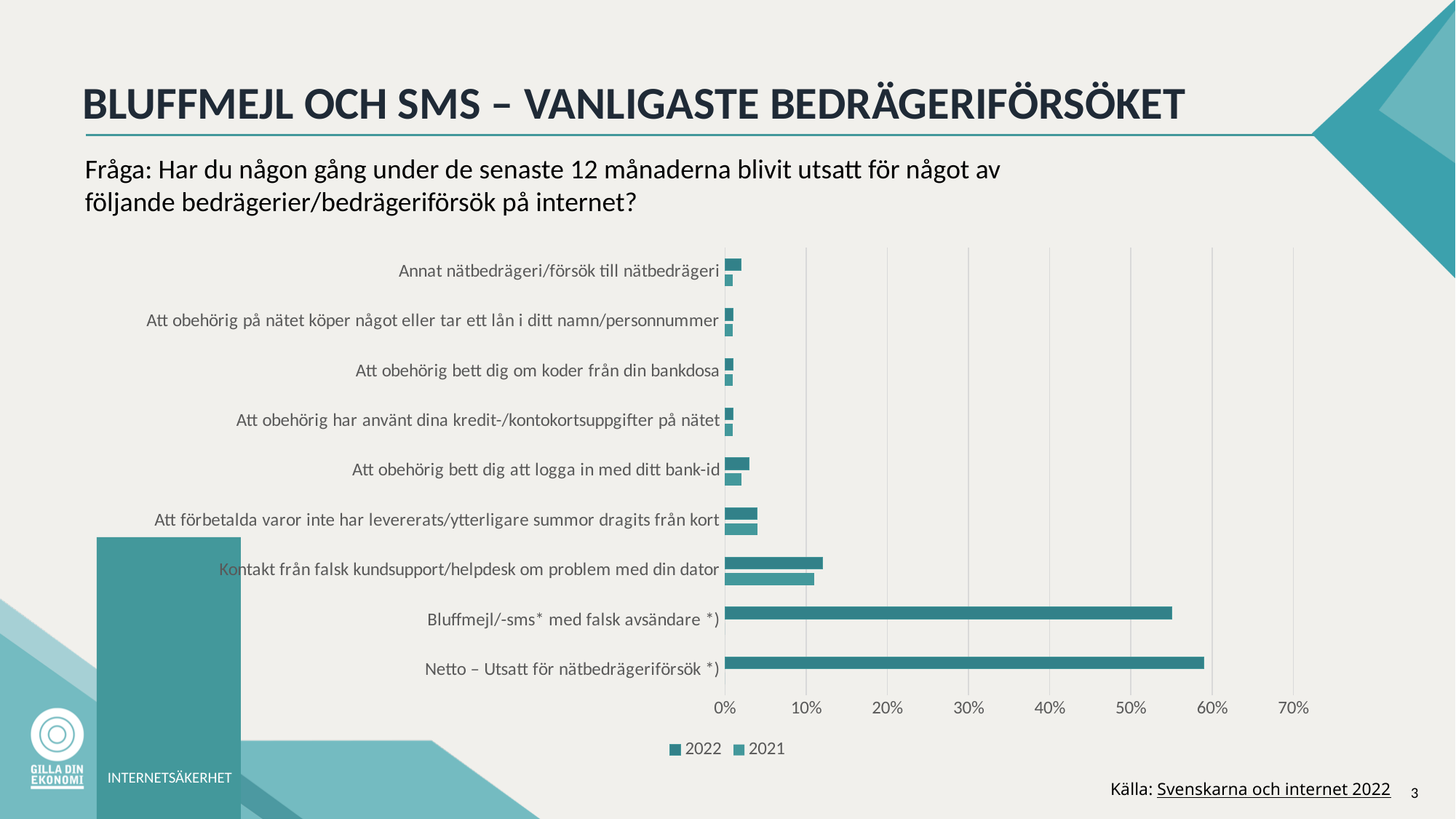
Is the 2022 value for "Att förbetalda varor inte har levererats/ytterligare summor dragits från kort" greater or less than 10%? less Which has the larger 2022 value: "Netto – Utsatt för nätbedrägeriförsök *)" or "Bluffmejl/-sms* med falsk avsändare *)"? Netto – Utsatt för nätbedrägeriförsök *) How many series does the legend list? 2 What is the highest value shown on the horizontal axis of the chart? 70% Is the 2022 value for "Netto – Utsatt för nätbedrägeriförsök *)" greater or less than 50%? greater How many categories are shown on the vertical axis of the chart? 9 Is the 2022 value for "Bluffmejl/-sms* med falsk avsändare *)" greater or less than 60%? less Which category has the longest bar for 2022? Netto – Utsatt för nätbedrägeriförsök *) Which years are listed in the chart legend? 2022 and 2021 What kind of chart is shown on the slide? Bar chart Which has the larger 2022 value: "Kontakt från falsk kundsupport/helpdesk om problem med din dator" or "Att obehörig bett dig att logga in med ditt bank-id"? Kontakt från falsk kundsupport/helpdesk om problem med din dator